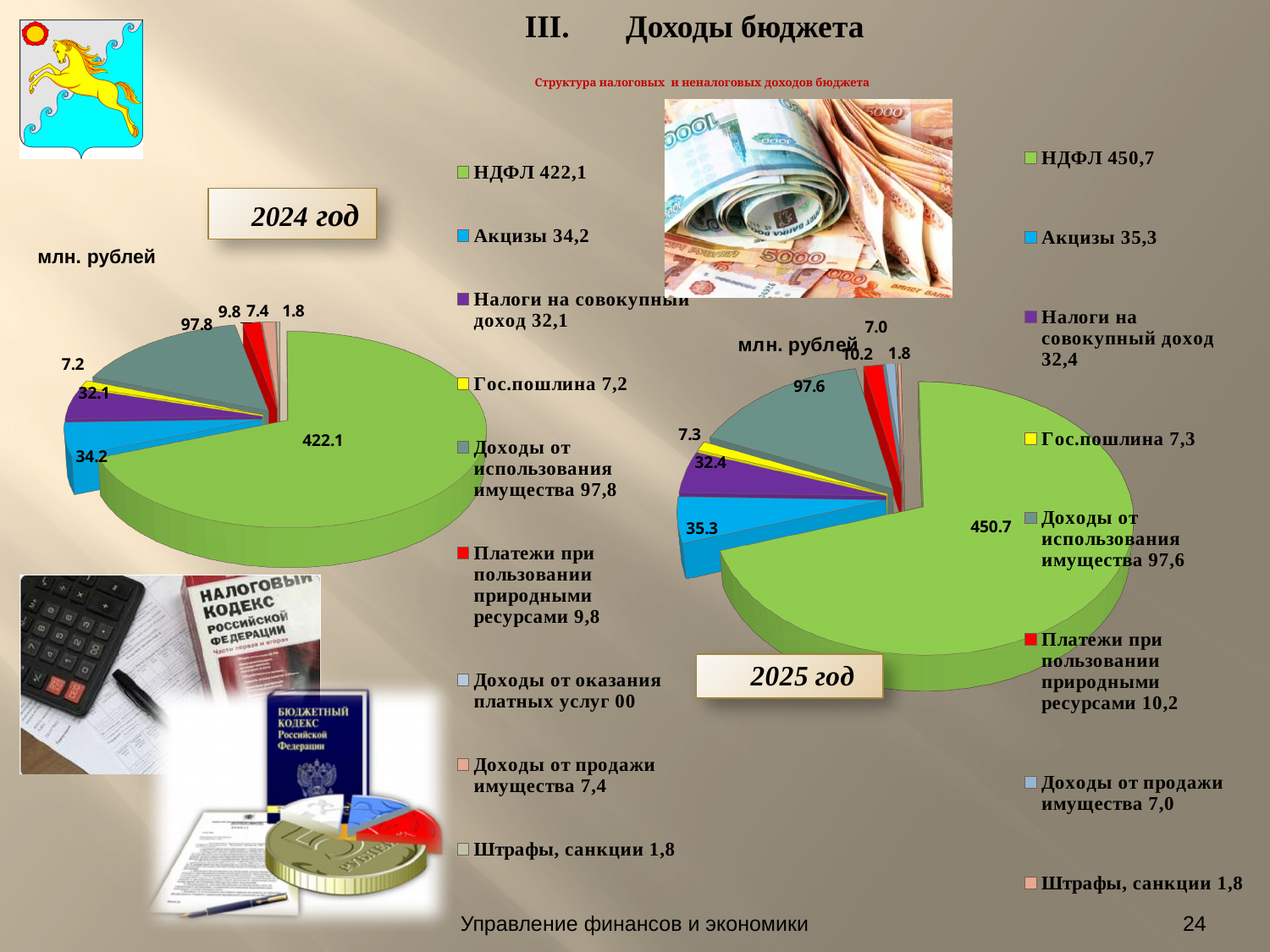
How many categories does the legend of the 2025 год pie chart list? 8 In the 2024 год pie chart, which is larger: Акцизы or Налоги на совокупный доход? Акцизы In the 2025 год pie chart, what is the value for Платежи при пользовании природными ресурсами? 10.2 How many categories does the legend of the 2024 год pie chart list? 9 In the 2024 год pie chart, which category has the smallest non-zero value? Штрафы, санкции What unit is indicated for the values in both pie charts? млн. рублей In the 2025 год pie chart, which category has the largest value? НДФЛ What is the difference between the НДФЛ value in the 2025 год chart and the НДФЛ value in the 2024 год chart? 28.6 In the 2025 год pie chart, what is the value for Акцизы? 35.3 In the 2024 год pie chart, what is the value for НДФЛ? 422.1 What type of chart is used to show the 2024 год budget revenue structure? Pie chart In the 2024 год pie chart, what is the value for Доходы от использования имущества? 97.8